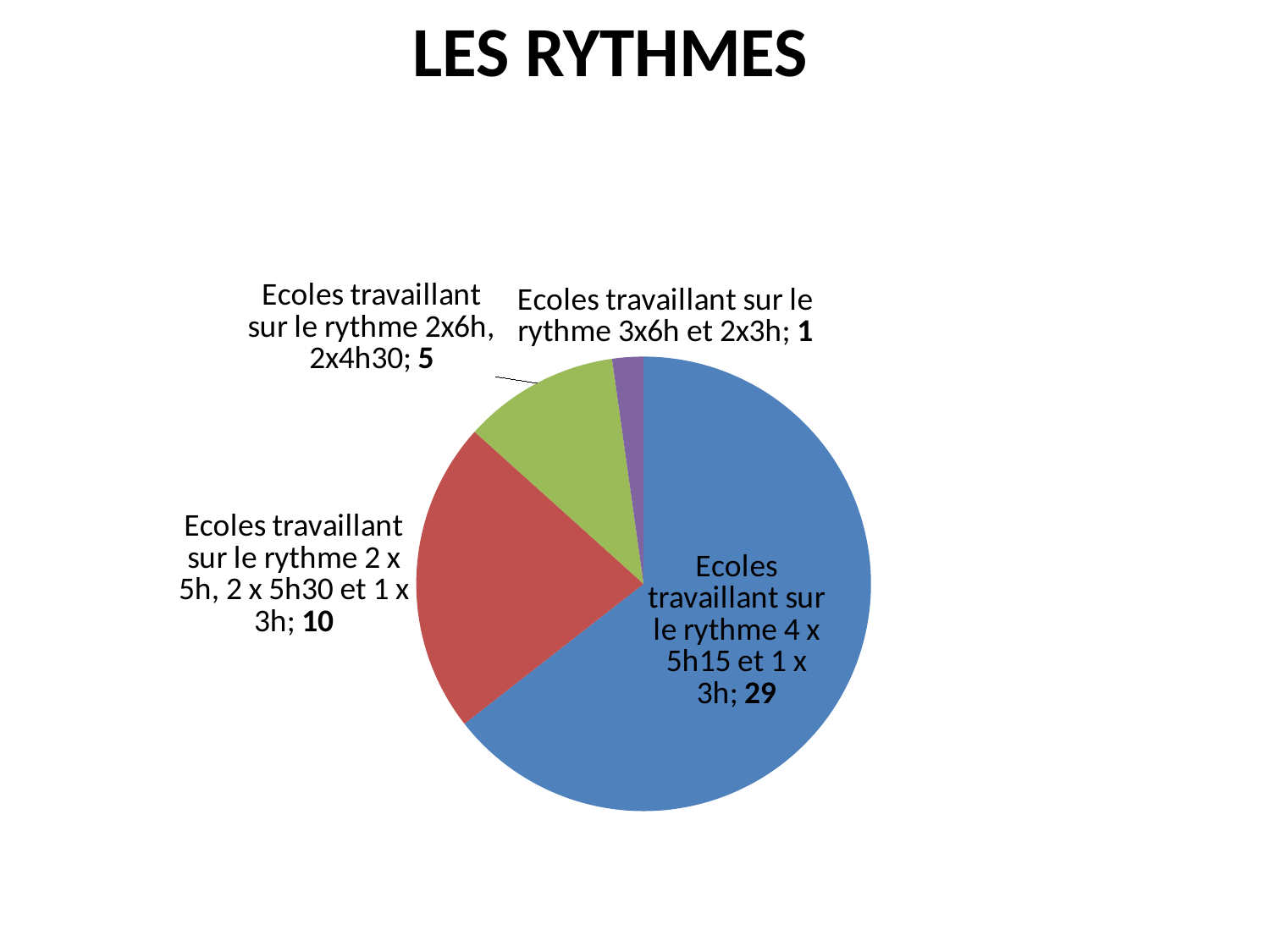
How many schools work on the rhythm 2 x 5h, 2 x 5h30 et 1 x 3h? 10 How many schools work on the rhythm 2x6h, 2x4h30? 5 Which is larger: the number of schools on the rhythm 2x6h, 2x4h30 or on the rhythm 3x6h et 2x3h? 2x6h, 2x4h30 How many slices does the pie chart have? 4 What is the title of the slide? LES RYTHMES What is the total number of schools represented in the pie chart? 45 What is the difference between the number of schools on the rhythm 4 x 5h15 et 1 x 3h and those on the rhythm 2 x 5h, 2 x 5h30 et 1 x 3h? 19 How many schools work on the rhythm 3x6h et 2x3h? 1 Which category has the largest slice of the pie? Ecoles travaillant sur le rythme 4 x 5h15 et 1 x 3h Which category has the smallest slice of the pie? Ecoles travaillant sur le rythme 3x6h et 2x3h What kind of chart is shown on the slide? pie chart How many schools work on the rhythm 4 x 5h15 et 1 x 3h? 29